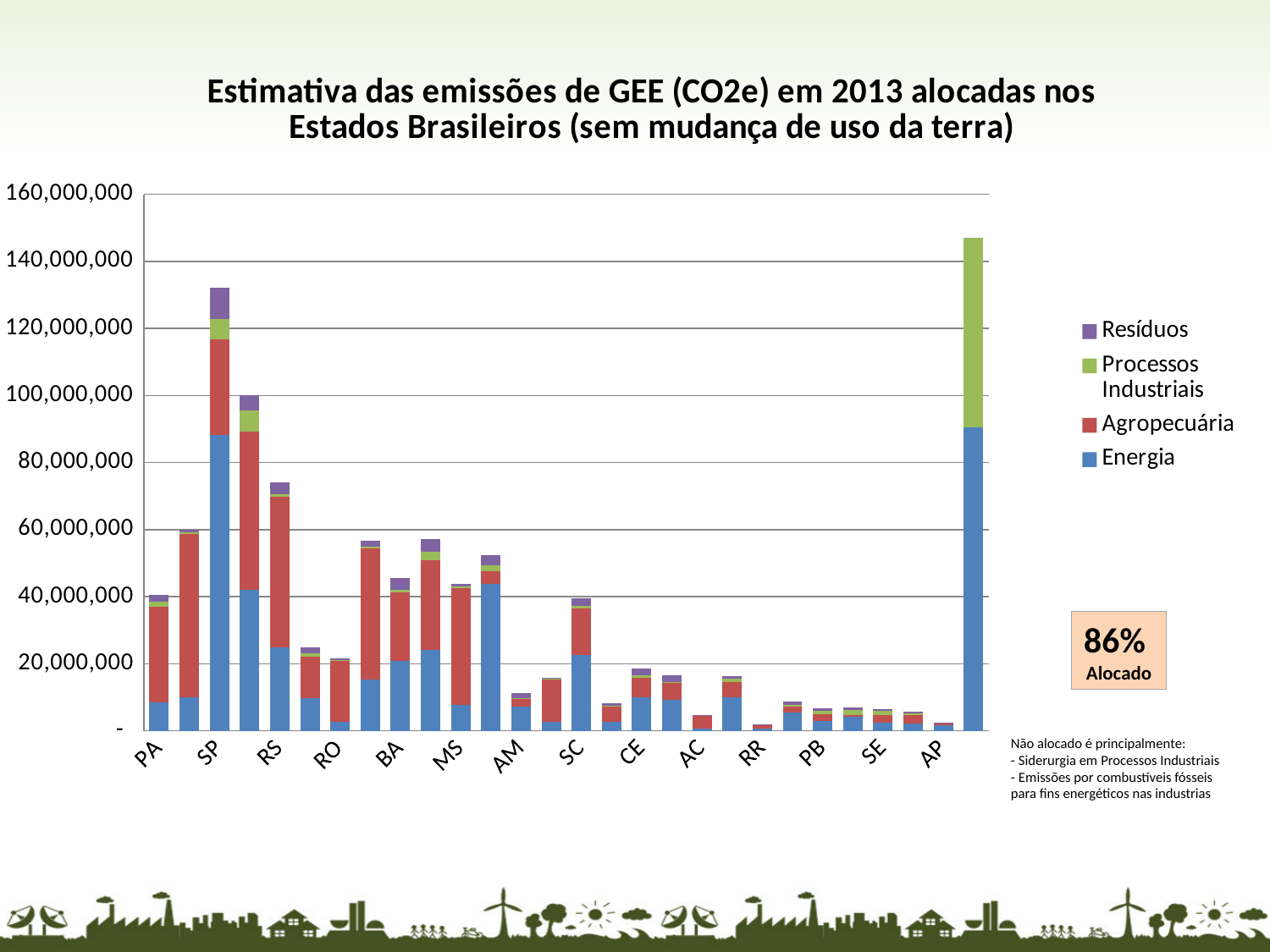
Which has the larger total bar, BA or AM? BA Which series is shown in green in the legend? Processos Industriais Is the total value for SP greater or less than 120,000,000? greater What kind of chart is shown on the slide? Stacked bar chart How many series does the legend list? 4 Is the total value for RS greater or less than 60,000,000? greater Which has the larger total bar, SP or RS? SP What percentage is shown in the box labelled 'Alocado'? 86% Among the labelled states, which has the tallest stacked bar? SP Is the total value for AM greater or less than 20,000,000? less